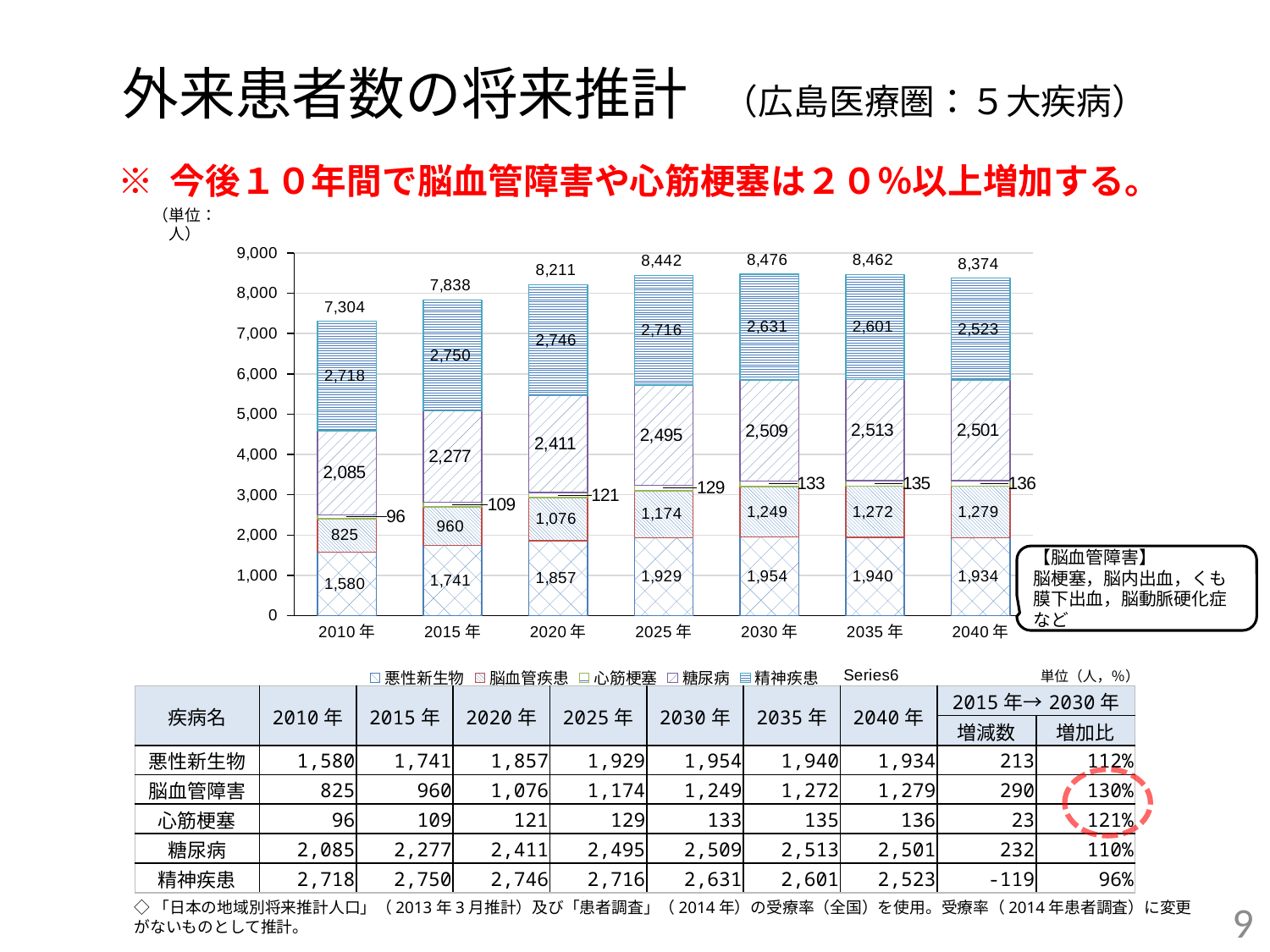
What is the value of the 精神疾患 segment in the 2020年 bar? 2,746 What type of chart is shown on the slide? stacked bar chart What is the difference between the 脳血管疾患 values for 2030年 and 2015年? 289 How many year categories are plotted on the x axis of the chart? 7 What is the total value labeled above the bar for 2010年? 7,304 Which is larger, the 悪性新生物 value for 2030年 or for 2040年? 2030年 Which year has the lowest total value labeled above its bar? 2010年 Does the 精神疾患 series rise or fall from 2020年 to 2040年? fall What is the value of the 心筋梗塞 segment in the 2015年 bar? 109 What is the value of the 糖尿病 segment in the 2035年 bar? 2,513 Which year has the highest total value labeled above its bar? 2030年 How many series does the chart legend list? 6